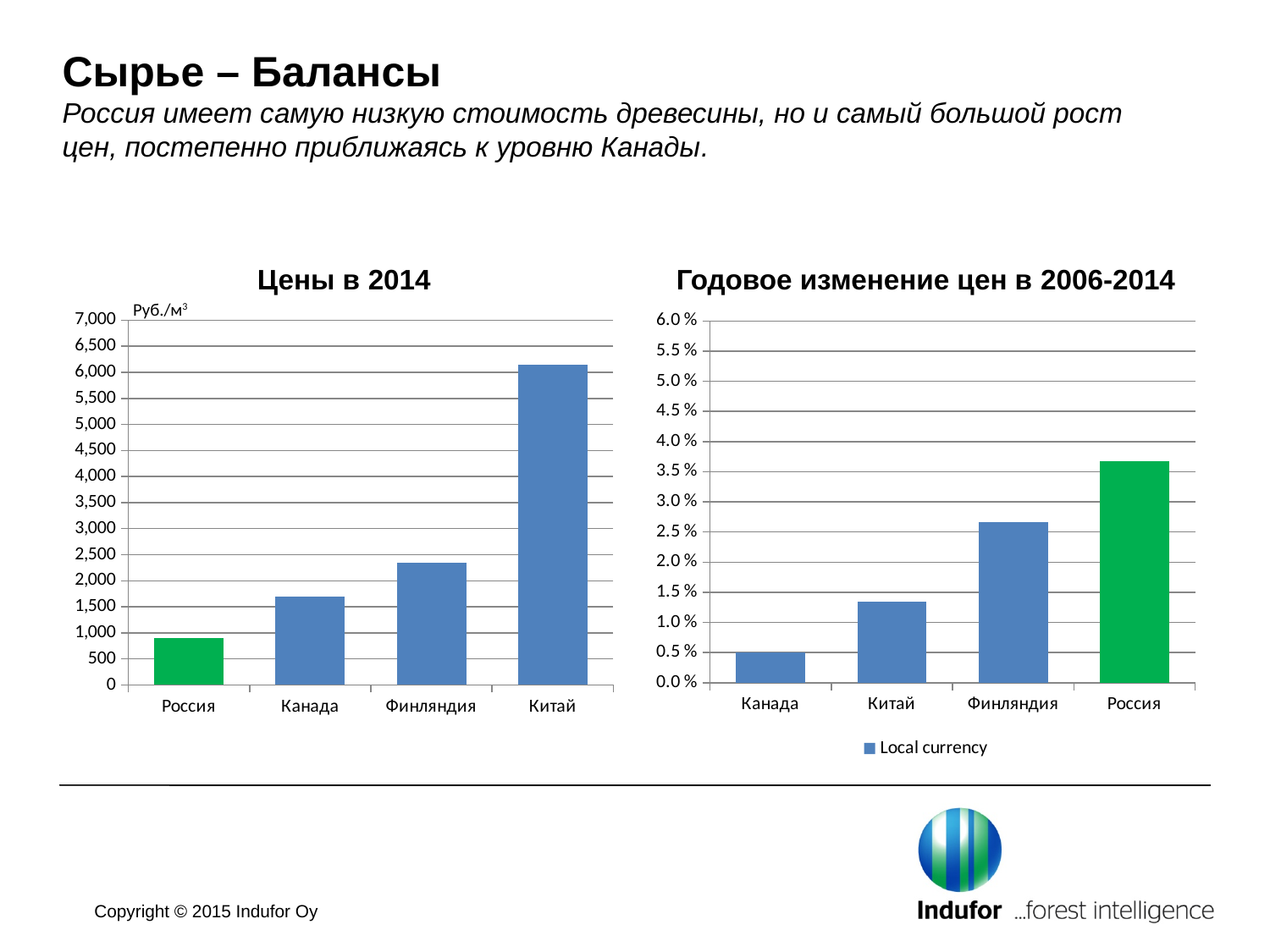
In the 'Годовое изменение цен в 2006-2014' chart, which category has the lowest value? Канада In the 'Годовое изменение цен в 2006-2014' chart, which category has the highest value? Россия How many categories are shown in the 'Цены в 2014' chart? 4 In the 'Годовое изменение цен в 2006-2014' chart, is the value for Финляндия greater or less than 2.0 %? greater In the 'Цены в 2014' chart, which category has the lowest value? Россия In the 'Годовое изменение цен в 2006-2014' chart, which is larger, the value for Китай or the value for Финляндия? Финляндия What type of chart is the 'Цены в 2014' chart? bar chart What legend entry is shown under the 'Годовое изменение цен в 2006-2014' chart? Local currency In the 'Цены в 2014' chart, which category has the highest value? Китай In the 'Цены в 2014' chart, is the value for Финляндия greater or less than 2,000? greater In the 'Цены в 2014' chart, is the value for Китай greater or less than 5,500? greater